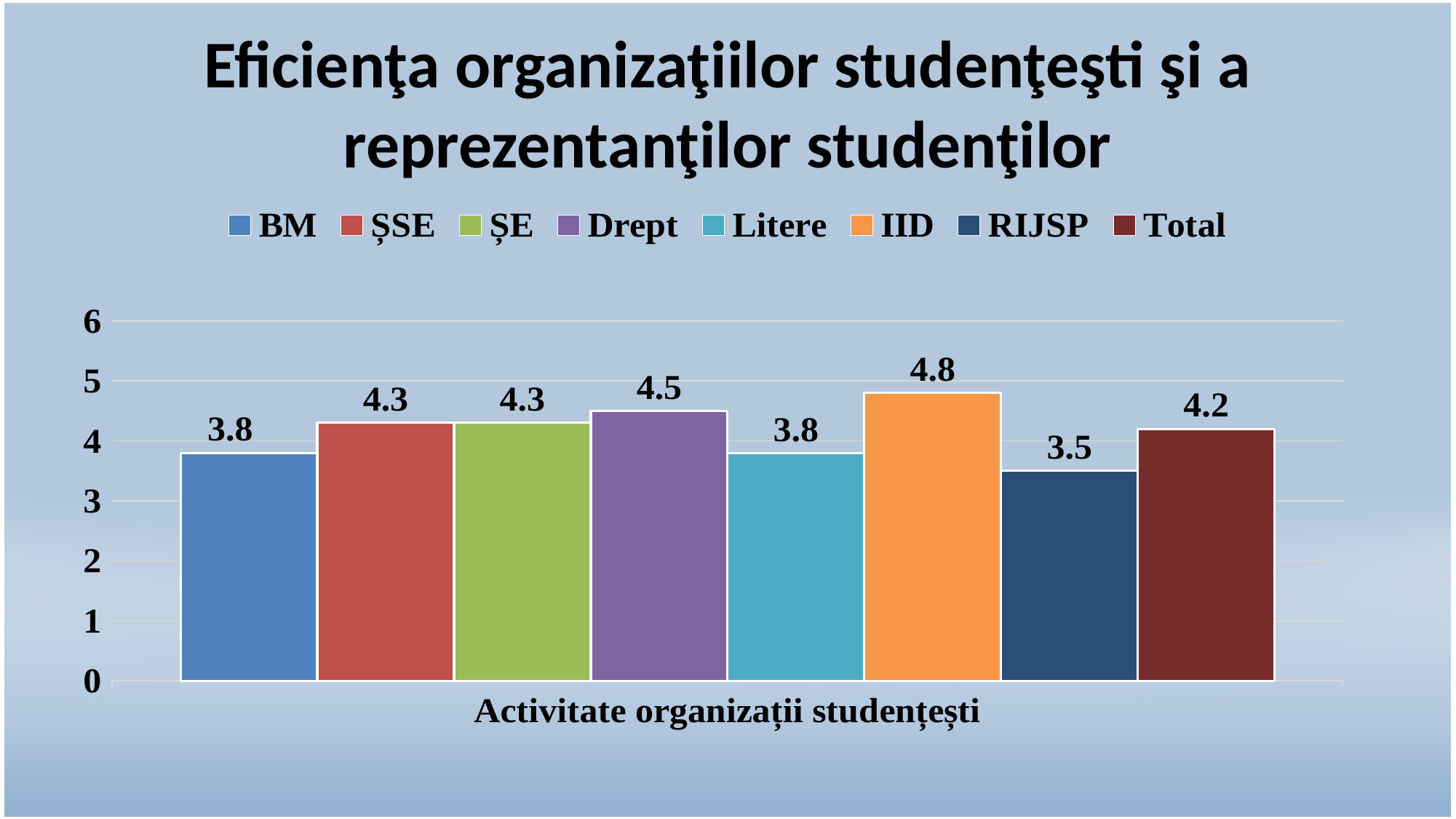
What is the value for Drept? 4.5 What is the difference between the values for IID and RIJSP? 1.3 What is the label on the x axis of the chart? Activitate organizații studențești What is the value for RIJSP? 3.5 How many series does the legend list? 8 Which series has the lowest value? RIJSP What kind of chart is shown on the slide? bar chart Which series has the highest value? IID What is the value for Total? 4.2 Which is larger, the value for Drept or the value for Litere? Drept Is the value for BM greater or less than 4? less What is the value for IID? 4.8